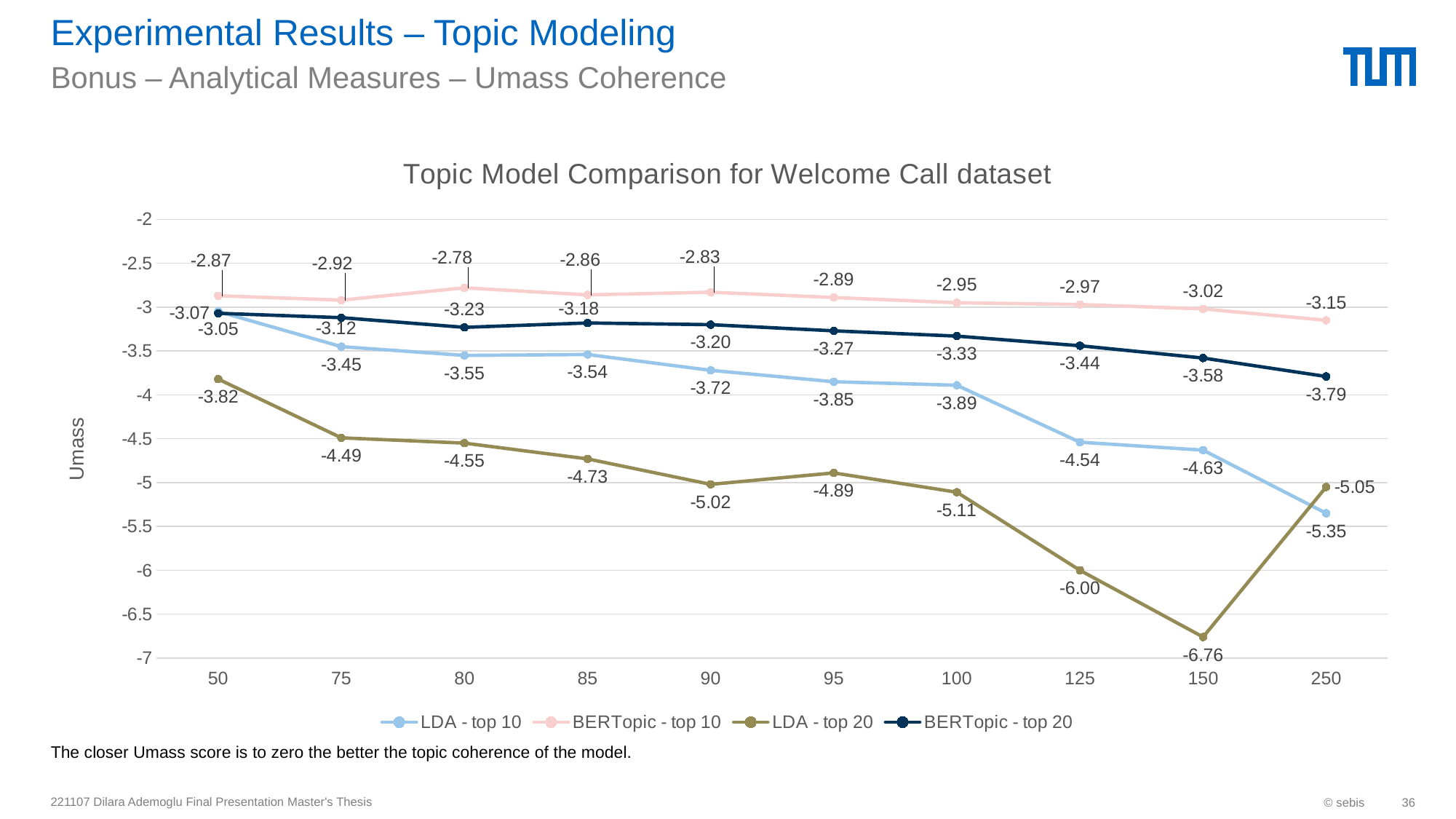
What is the label of the y axis? Umass How many series does the legend of the chart list? 4 What is the difference between the BERTopic - top 10 value and the LDA - top 10 value at 250? 2.20 At 125, which series has the higher Umass value: LDA - top 10 or LDA - top 20? LDA - top 10 At which x-axis value does BERTopic - top 10 reach its highest Umass score? 80 What is the Umass value for BERTopic - top 10 at 80? -2.78 What is the Umass value for BERTopic - top 20 at 100? -3.33 What kind of chart is shown on the slide? line chart Does the LDA - top 10 series generally rise or fall as the x-axis value increases? fall How many points along the x axis does each series have? 10 At which x-axis value does LDA - top 20 reach its lowest Umass score? 150 What is the Umass value for LDA - top 20 at 150? -6.76